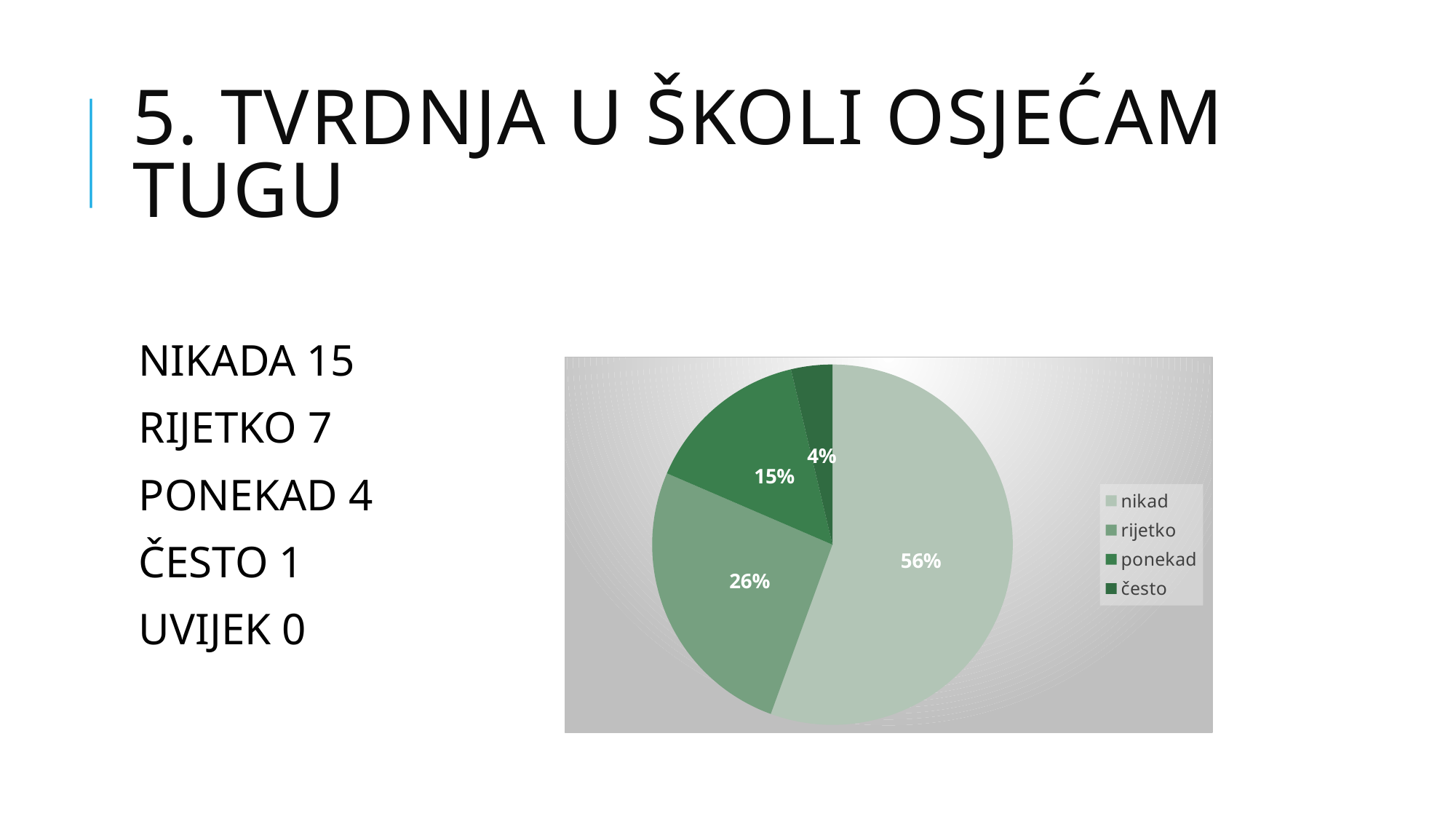
Which category has the smallest slice of the pie? često What share of the pie does the 'nikad' slice represent? 56% What share of the pie does the 'često' slice represent? 4% Which category has the largest slice of the pie? nikad What share of the pie does the 'rijetko' slice represent? 26% Which slice is larger, 'ponekad' or 'rijetko'? rijetko What is the difference in percentage points between the 'ponekad' and 'često' slices? 11 What kind of chart is shown on the slide? pie chart What is the difference in percentage points between the 'nikad' and 'rijetko' slices? 30 Which legend entry is shown with the darkest green colour? često How many categories does the legend list? 4